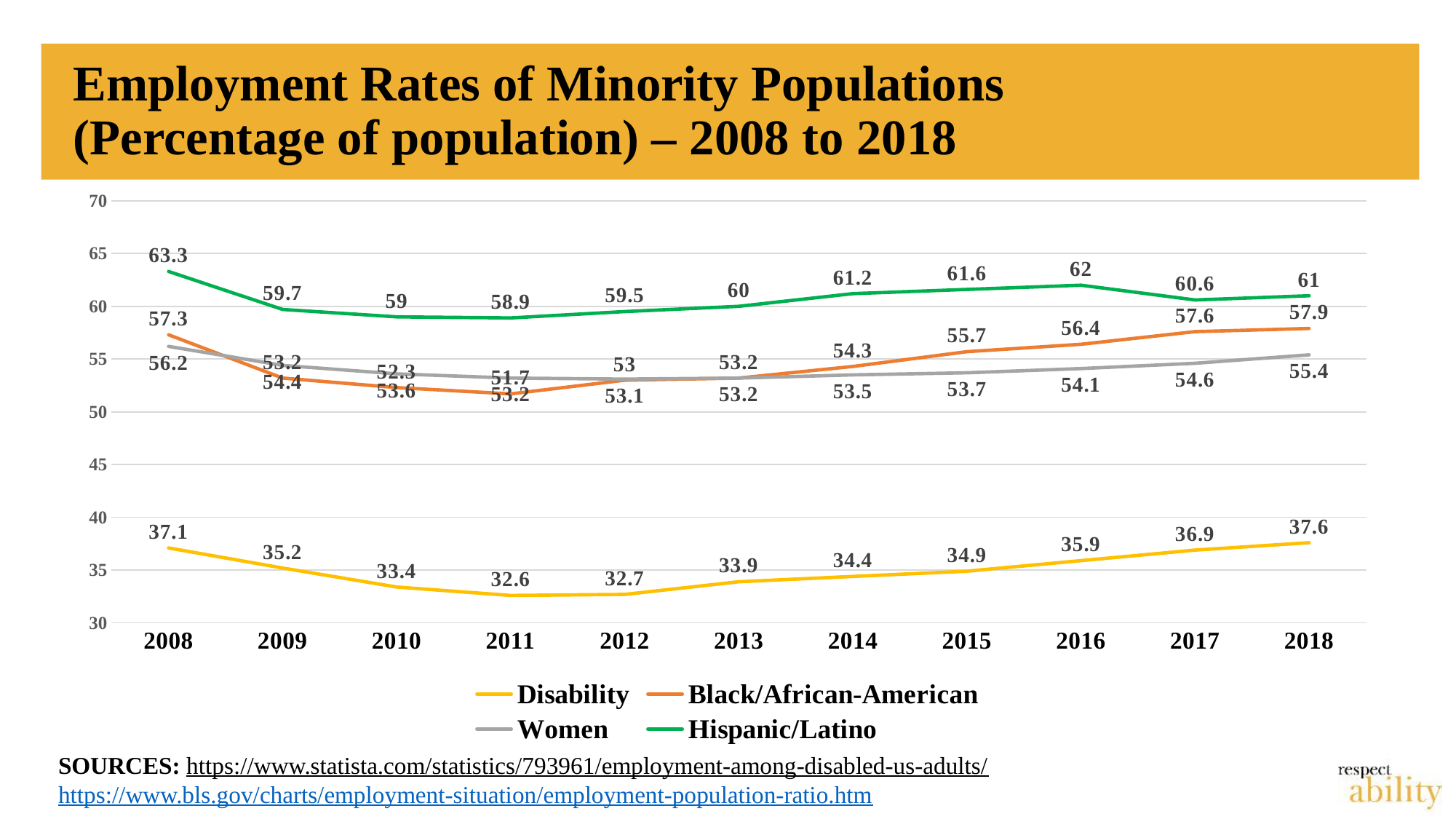
What is the difference between the Hispanic/Latino rate and the Disability rate in 2018? 23.4 In which year is the Hispanic/Latino employment rate highest? 2008 In which year is the Disability employment rate lowest? 2011 How does the Disability employment rate change from 2011 to 2018? It rises What type of chart is shown on the slide? line chart What is the employment rate for Black/African-American in 2018? 57.9 How many years are plotted along the x axis? 11 Which series has the higher value in 2015, Black/African-American or Women? Black/African-American What is the employment rate for Hispanic/Latino in 2016? 62 What is the employment rate for Women in 2008? 56.2 How many series does the legend list? 4 What is the employment rate for the Disability series in 2011? 32.6